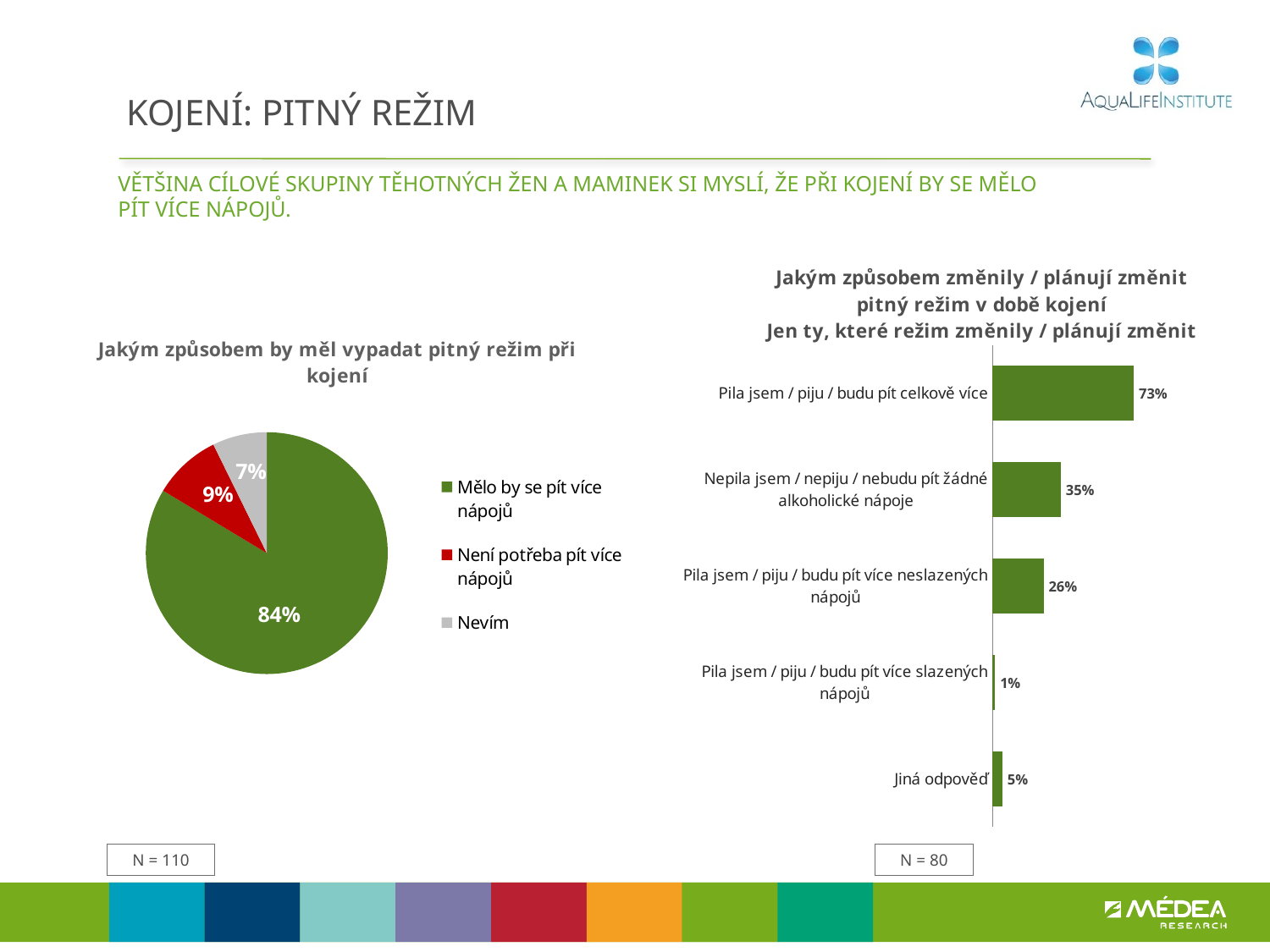
In the pie chart 'Jakým způsobem by měl vypadat pitný režim při kojení', what share is 'Není potřeba pít více nápojů'? 9% How many categories does the bar chart on the right show? 5 How many entries does the legend of the pie chart on the left list? 3 In the bar chart 'Jakým způsobem změnily / plánují změnit pitný režim v době kojení', what is the value for 'Pila jsem / piju / budu pít celkově více'? 73% In the pie chart on the left, which category has the smallest share? Nevím What type of chart is the chart on the left of the slide? Pie chart In the bar chart on the right, which is larger: 'Jiná odpověď' or 'Pila jsem / piju / budu pít více slazených nápojů'? Jiná odpověď In the bar chart 'Jakým způsobem změnily / plánují změnit pitný režim v době kojení', what is the value for 'Nepila jsem / nepiju / nebudu pít žádné alkoholické nápoje'? 35% In the bar chart on the right, which category has the lowest value? Pila jsem / piju / budu pít více slazených nápojů In the bar chart on the right, what is the difference between 'Pila jsem / piju / budu pít celkově více' and 'Pila jsem / piju / budu pít více neslazených nápojů'? 47% In the pie chart 'Jakým způsobem by měl vypadat pitný režim při kojení', what share is 'Nevím'? 7% In the pie chart 'Jakým způsobem by měl vypadat pitný režim při kojení', what share is 'Mělo by se pít více nápojů'? 84%